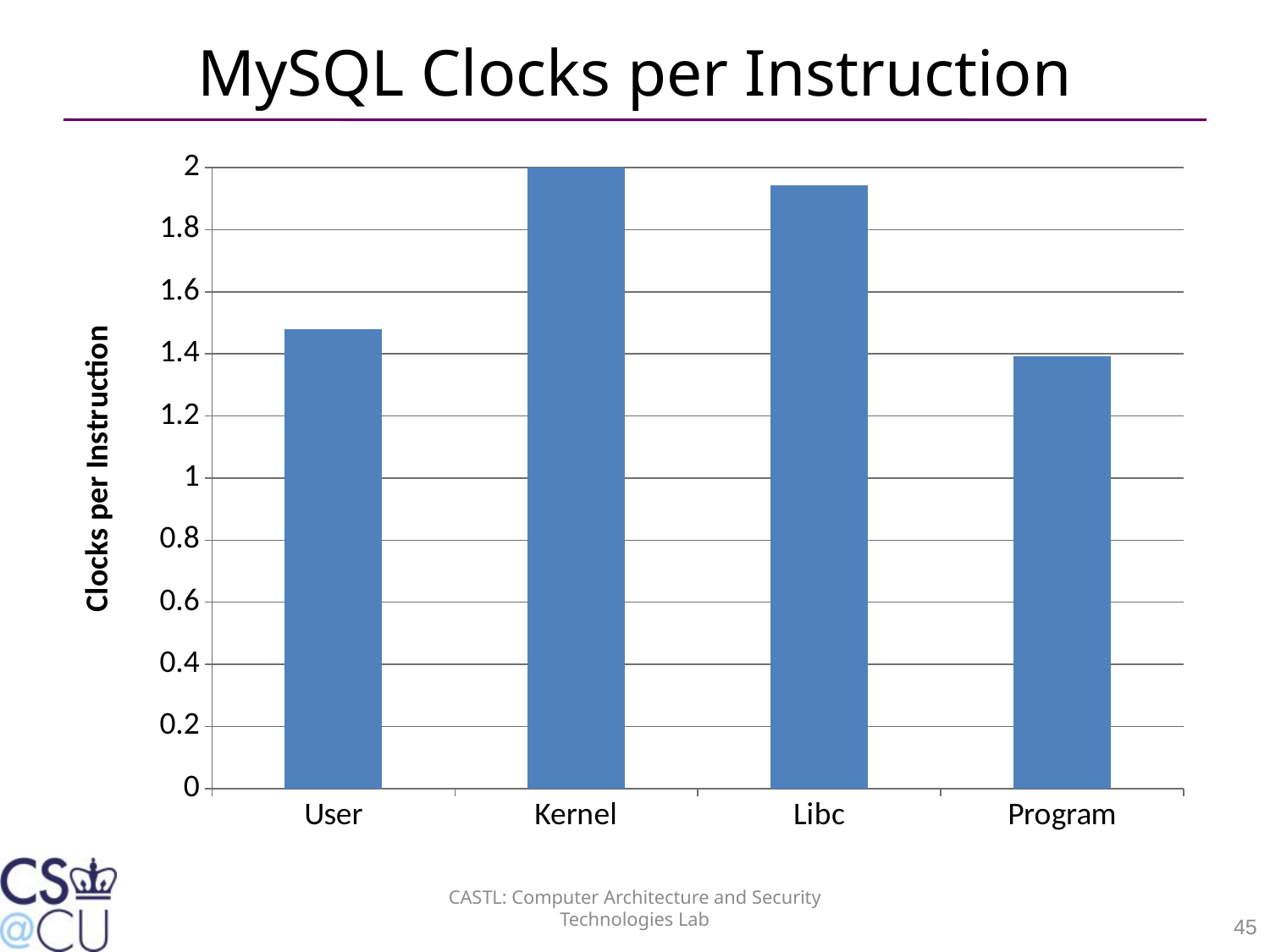
Which has a higher clocks per instruction value, User or Libc? Libc Which has a higher clocks per instruction value, Kernel or Program? Kernel Is the value for User greater or less than 1.6? less Which category has the highest clocks per instruction? Kernel What is the label of the vertical axis? Clocks per Instruction Is the value for User greater or less than 1.4? greater Is the value for Program greater or less than 1.2? greater What is the clocks per instruction value for Kernel? 2 How many categories are plotted in the chart? 4 Which category has the lowest clocks per instruction? Program What type of chart is shown on the slide? bar chart